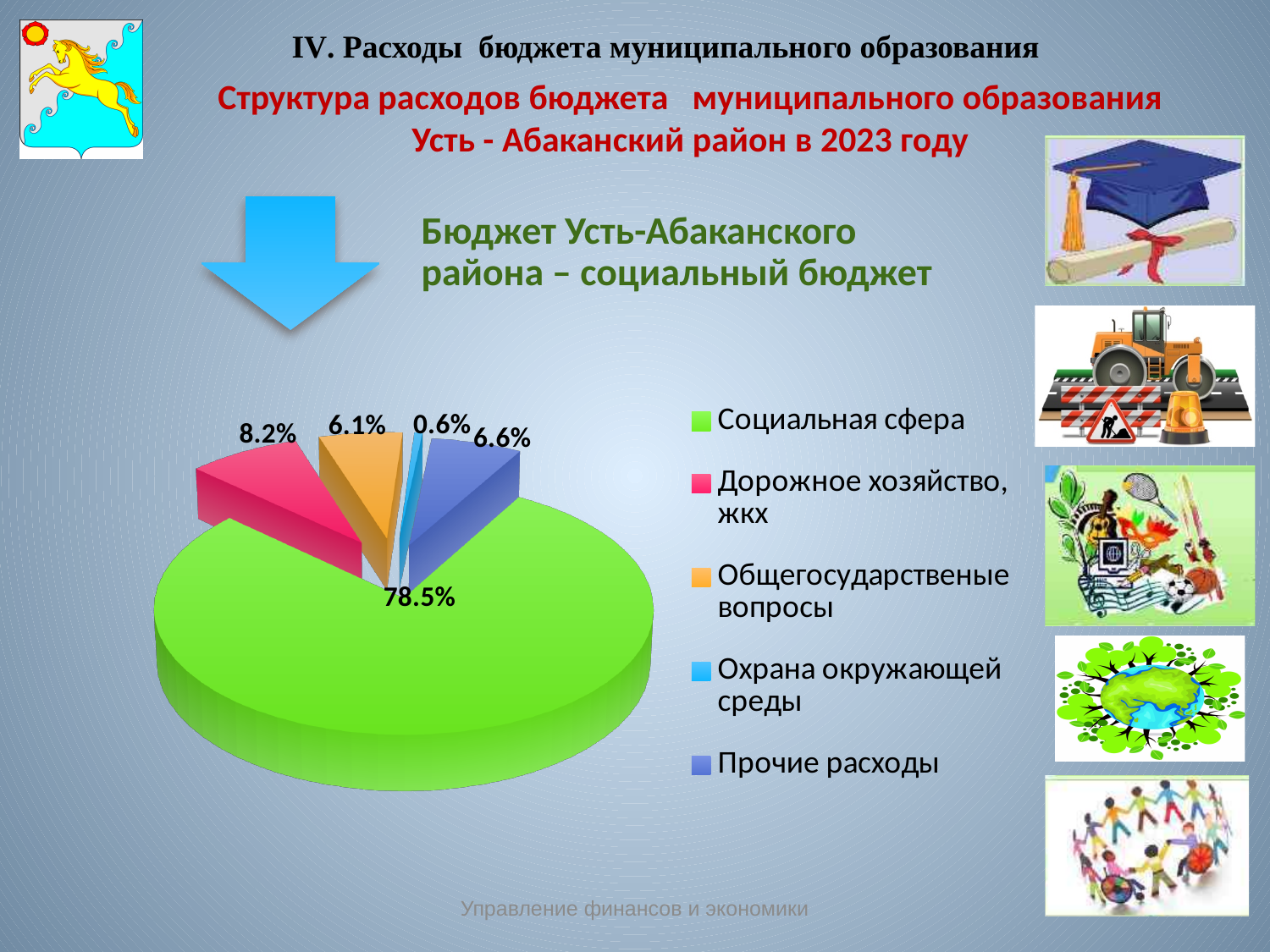
What percentage is shown for Прочие расходы? 6.6% Which is larger: the share for Прочие расходы or the share for Общегосударственые вопросы? Прочие расходы Which category has the smallest share of the pie? Охрана окружающей среды What percentage is shown for Общегосударственые вопросы? 6.1% What percentage is shown for Дорожное хозяйство, жкх? 8.2% What share of the budget expenditure goes to Социальная сфера? 78.5% What is the difference in percentage points between Социальная сфера and Дорожное хозяйство, жкх? 70.3 What type of chart is shown on the slide? Pie chart Which category has the largest share of the pie? Социальная сфера How many slices does the pie chart have? 5 What percentage is shown for Охрана окружающей среды? 0.6% What colour is the slice for Социальная сфера? Green